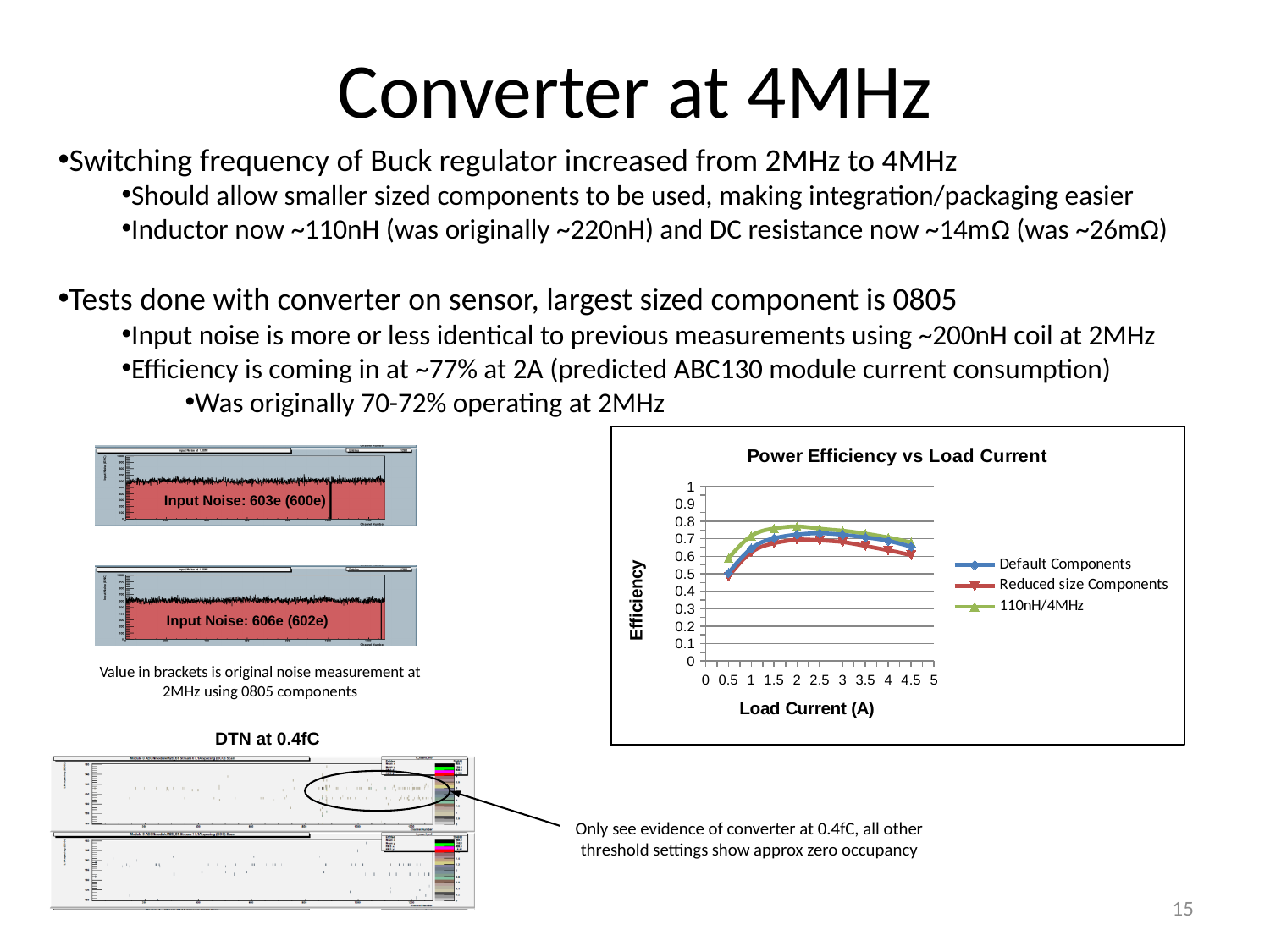
In the 'Power Efficiency vs Load Current' chart, is the efficiency of the Reduced size Components series at 4.5 A greater or less than 0.5? greater In the 'Power Efficiency vs Load Current' chart, at 2 A, which series has the higher efficiency: 110nH/4MHz or Reduced size Components? 110nH/4MHz In the 'Power Efficiency vs Load Current' chart, which series has the highest efficiency at a load current of 2 A? 110nH/4MHz In the 'Power Efficiency vs Load Current' chart, is the efficiency of the 110nH/4MHz series at 2 A greater or less than 0.7? greater In the 'Power Efficiency vs Load Current' chart, is the efficiency of the Default Components series at 0.5 A greater or less than 0.6? less In the 'Power Efficiency vs Load Current' chart, which series has the lowest efficiency at a load current of 4.5 A? Reduced size Components What kind of chart is the 'Power Efficiency vs Load Current' chart? line chart In the 'Power Efficiency vs Load Current' chart, how many data points are plotted for the 110nH/4MHz series? 9 What is the x-axis label of the 'Power Efficiency vs Load Current' chart? Load Current (A) In the 'Power Efficiency vs Load Current' chart, which series is drawn in green with triangle markers? 110nH/4MHz How many series does the legend of the 'Power Efficiency vs Load Current' chart list? 3